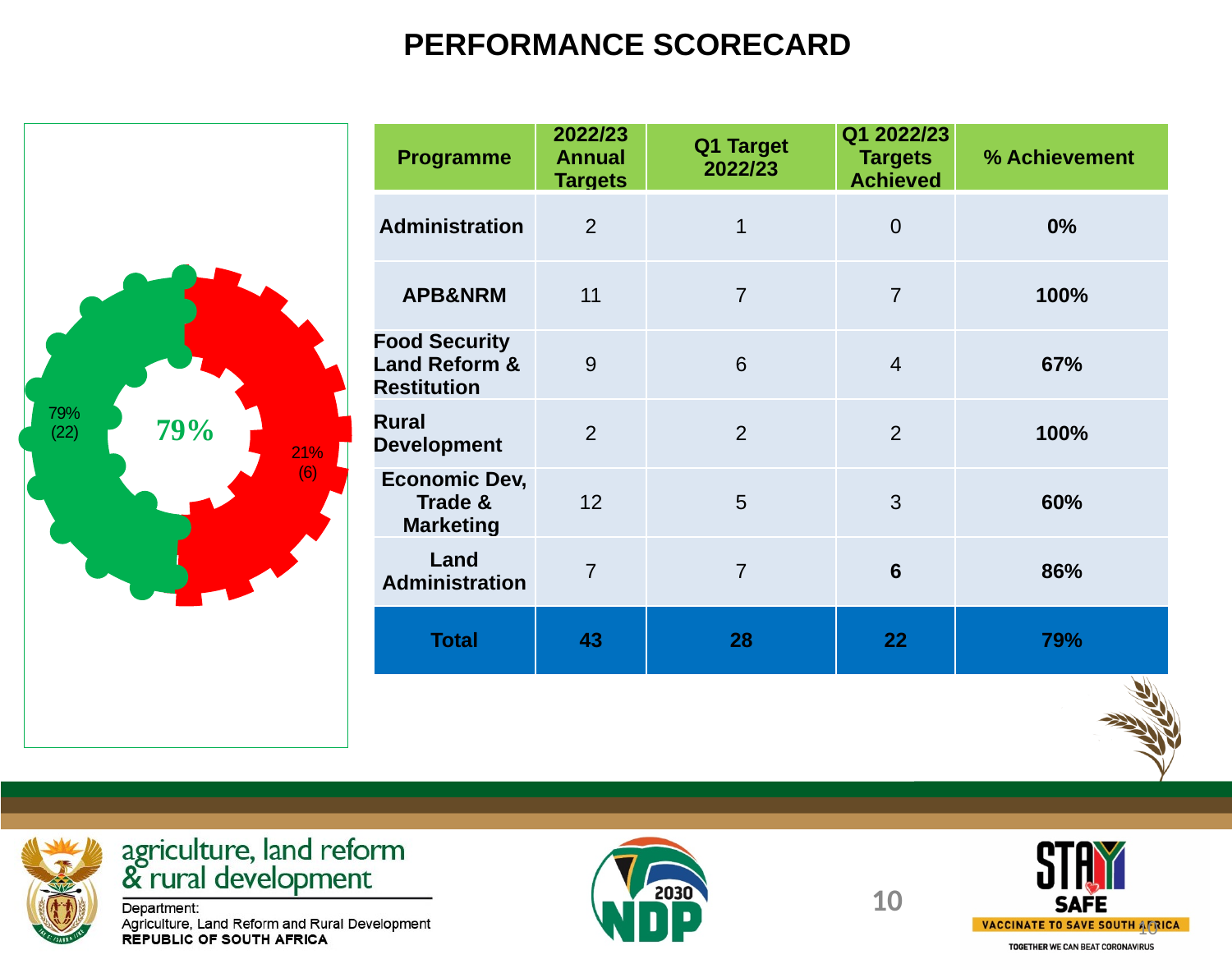
What percentage is shown for the red slice of the doughnut chart? 21% What count is shown in parentheses for the green slice of the doughnut chart? 22 What count is shown in parentheses for the red slice of the doughnut chart? 6 What kind of chart is shown on the left of the slide? doughnut chart What percentage is shown for the green slice of the doughnut chart? 79% What is the difference in percentage points between the green and red slices of the doughnut chart? 58 What is the difference between the counts shown for the green slice (22) and the red slice (6) of the doughnut chart? 16 What value is printed in the centre of the doughnut chart? 79% How many slices does the doughnut chart on the left have? 2 Which slice of the doughnut chart is the smallest? the red slice (21%) What colour is the slice representing 21% in the doughnut chart? red Which slice of the doughnut chart is larger, the green one or the red one? green